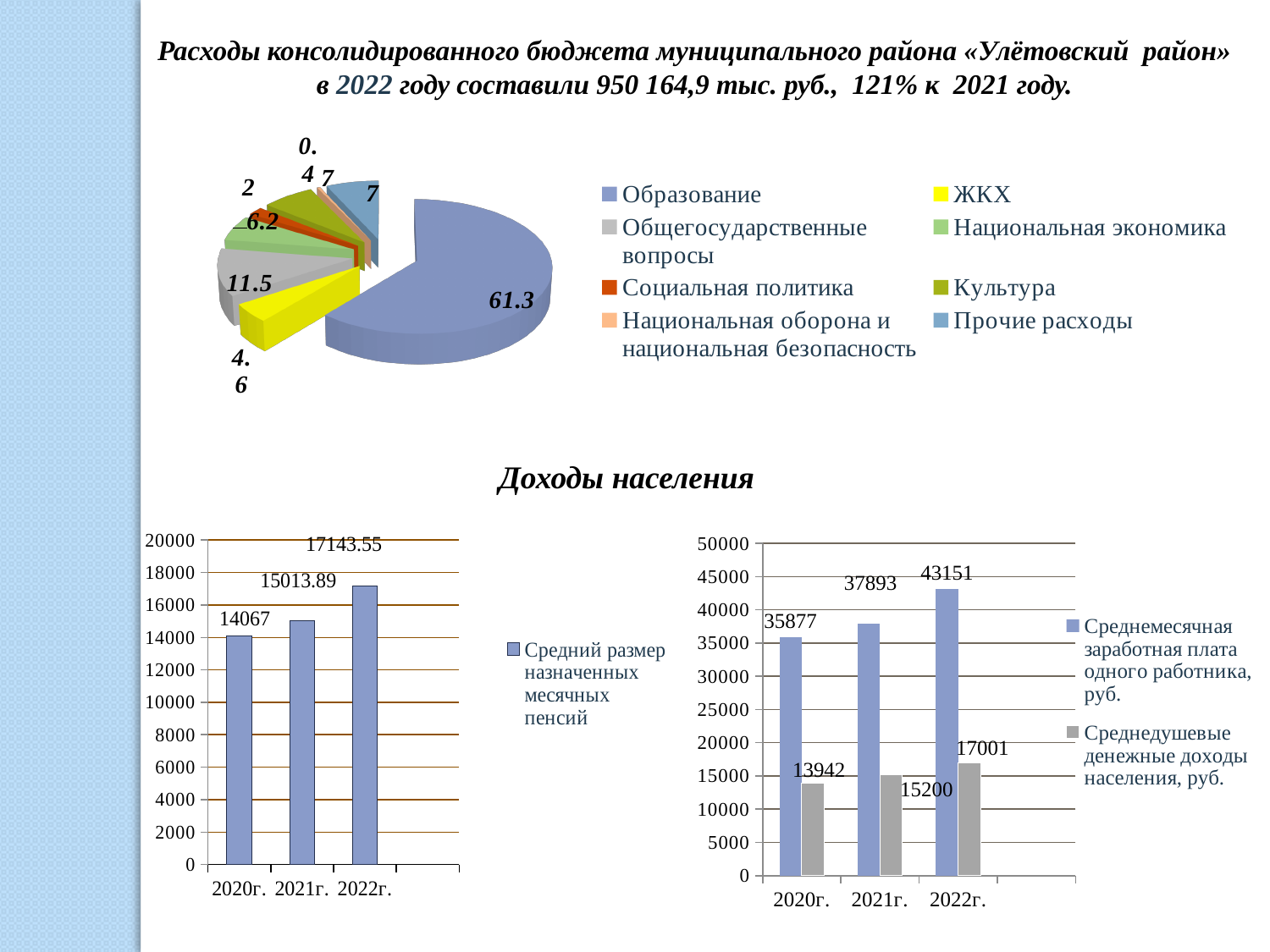
In the pie chart at the top of the slide, what value is shown for Общегосударственные вопросы? 11.5 In the bottom-right chart (Доходы населения), what is the value of Среднедушевые денежные доходы населения for 2021г.? 15200 In the pie chart at the top of the slide, how many categories does the legend list? 8 In the pie chart at the top of the slide, what share is shown for Образование? 61.3 In the bottom-left chart (Средний размер назначенных месячных пенсий), what is the value for 2022г.? 17143.55 In the pie chart at the top of the slide, which category has the largest slice? Образование In the bottom-left chart (Средний размер назначенных месячных пенсий), what is the value for 2020г.? 14067 What type of chart is the bottom-right chart (Доходы населения)? bar chart In the bottom-right chart (Доходы населения), what is the Среднемесячная заработная плата одного работника for 2022г.? 43151 In the bottom-left chart (Средний размер назначенных месячных пенсий), do the values rise or fall from 2020г. to 2022г.? rise In the bottom-right chart (Доходы населения), what is the difference between Среднемесячная заработная плата in 2022г. and in 2021г.? 5258 In the bottom-right chart (Доходы населения), how many series does the legend list? 2